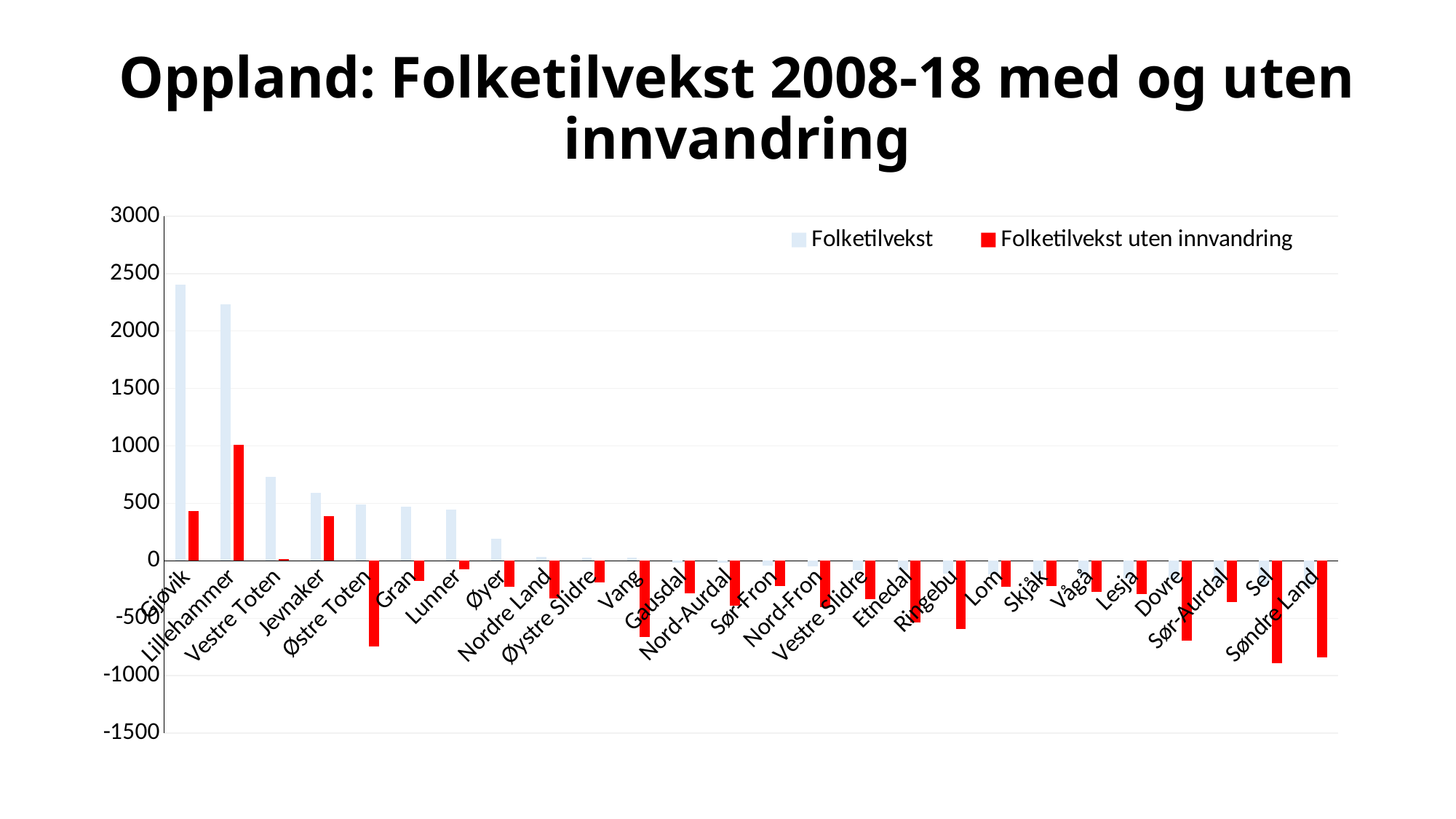
Is the Folketilvekst value for Vestre Toten greater or less than 500? greater Which series is shown in red? Folketilvekst uten innvandring Which municipality has the highest Folketilvekst uten innvandring value? Lillehammer Which municipality has the highest Folketilvekst value? Gjøvik What kind of chart is shown on the slide? bar chart Is the Folketilvekst uten innvandring value for Østre Toten greater or less than -500? less Do the Folketilvekst values generally rise or fall from left to right along the x axis? fall Is the Folketilvekst value for Gjøvik greater or less than 2000? greater How many municipalities (categories) are shown on the x axis? 26 How many series does the legend list? 2 Which is larger, the Folketilvekst value for Gjøvik or for Lillehammer? Gjøvik